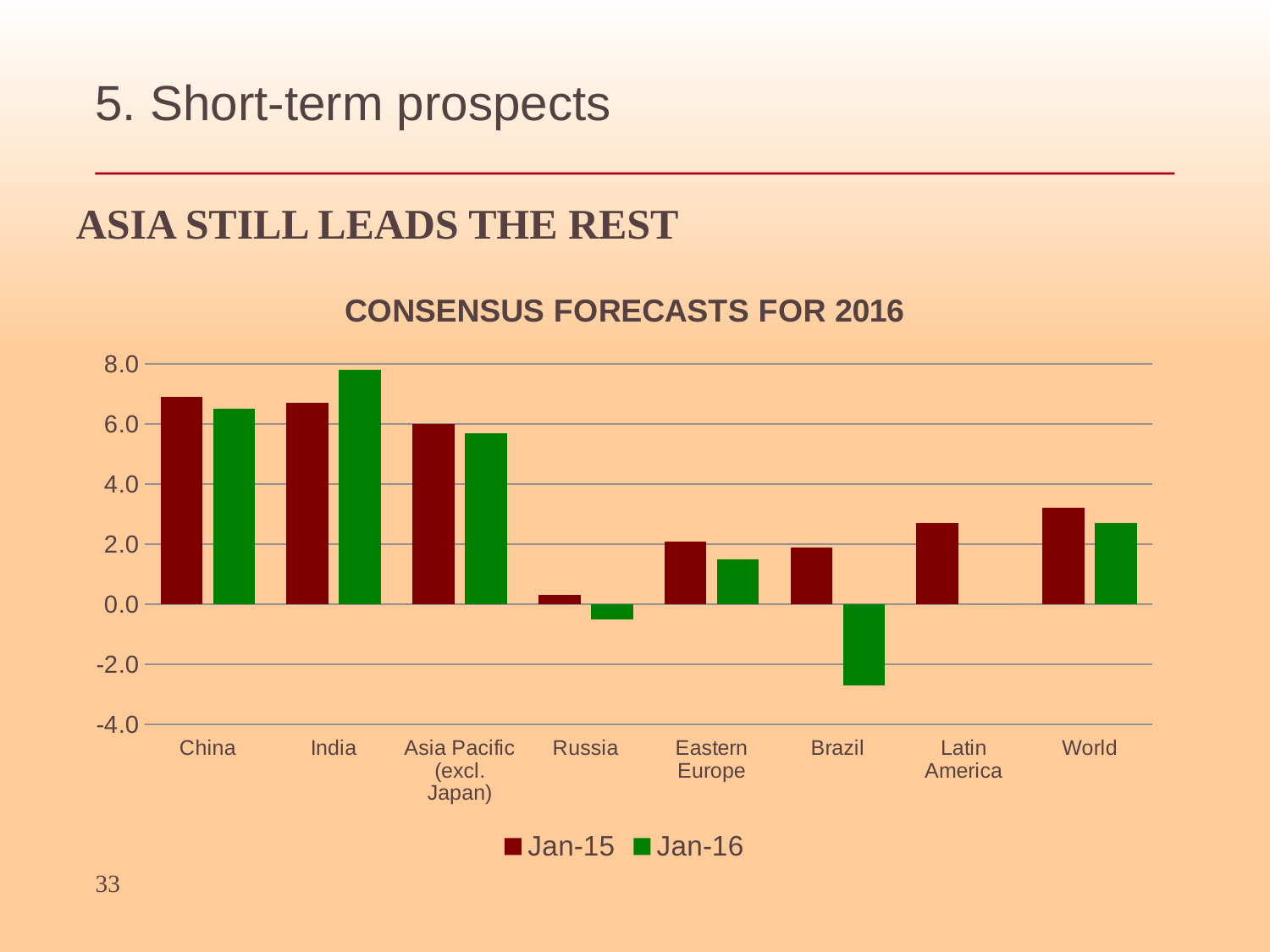
Which category has the lowest Jan-15 value? Russia Is the Jan-16 value for Brazil greater or less than -2.0? less For China, which is larger: the Jan-15 value or the Jan-16 value? Jan-15 For India, which is larger: the Jan-15 value or the Jan-16 value? Jan-16 How many categories are shown on the x axis? 8 Is the Jan-15 value for World greater or less than 4.0? less Is the Jan-16 value for India greater or less than 6.0? greater What is the title of the chart? CONSENSUS FORECASTS FOR 2016 What kind of chart is shown on the slide? bar chart Which category has the highest Jan-16 value? India Which category has the lowest Jan-16 value? Brazil How many series does the legend list? 2